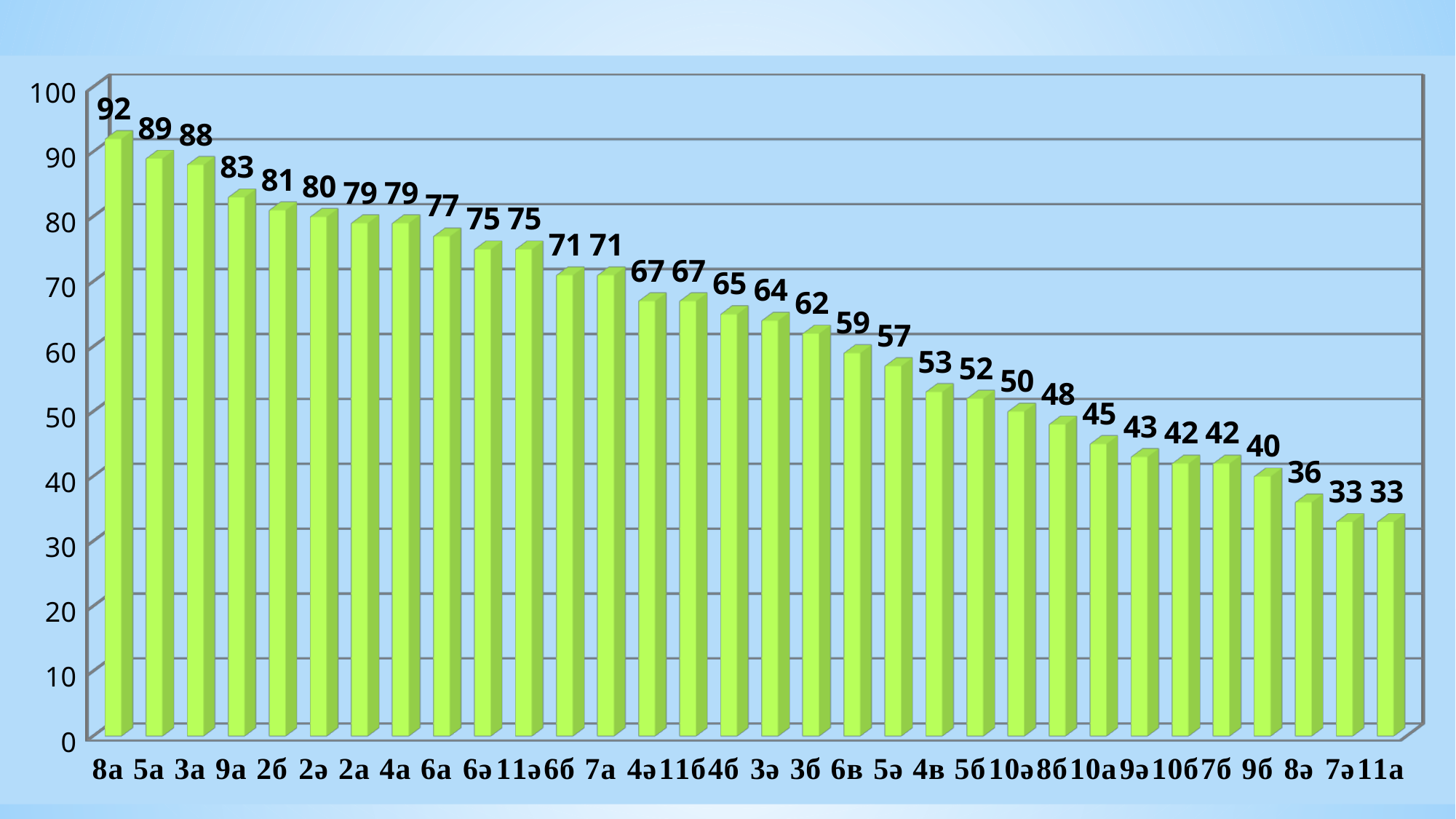
What is the value for 8а? 92 What is the value for 10ә? 50 What is the lowest value shown on the chart? 33 Which category has the highest value? 8а Do the values rise or fall from left to right along the x axis? Fall Which is larger, the value for 3ә or the value for 8б? 3ә What is the difference between the values for 9а and 5ә? 26 What is the value for 6в? 59 What kind of chart is shown on the slide? Bar chart How many categories are shown on the x axis? 32 What is the value for 9б? 40 What is the difference between the values for 8а and 11а? 59